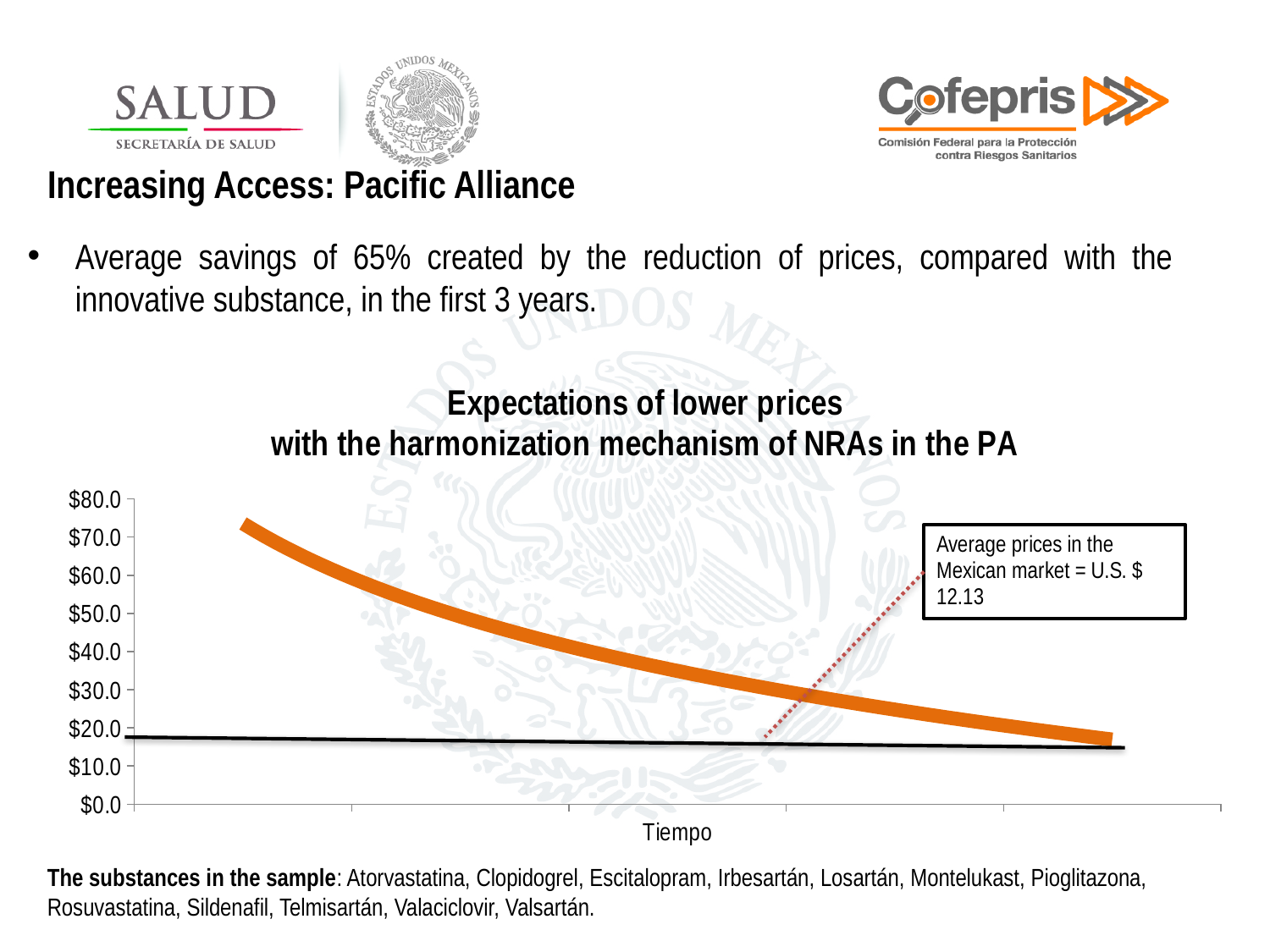
What is the highest value shown on the y axis of the chart? $80.0 Is the starting value of the orange line greater or less than $60.0? greater At the left side of the chart, which line has the higher value, the orange line or the black line? the orange line Does the orange line rise or fall as it moves along the x axis? fall According to the annotation on the chart, what is the average price in the Mexican market? U.S. $ 12.13 What kind of chart is shown on the slide? line chart Is the value of the orange line at the right end of the chart greater or less than $30.0? less How many lines are plotted on the chart (excluding the dotted annotation pointer)? 2 Is the value of the black line at the left edge of the chart greater or less than $30.0? less What is the title of the chart? Expectations of lower prices with the harmonization mechanism of NRAs in the PA What is the label on the x axis of the chart? Tiempo